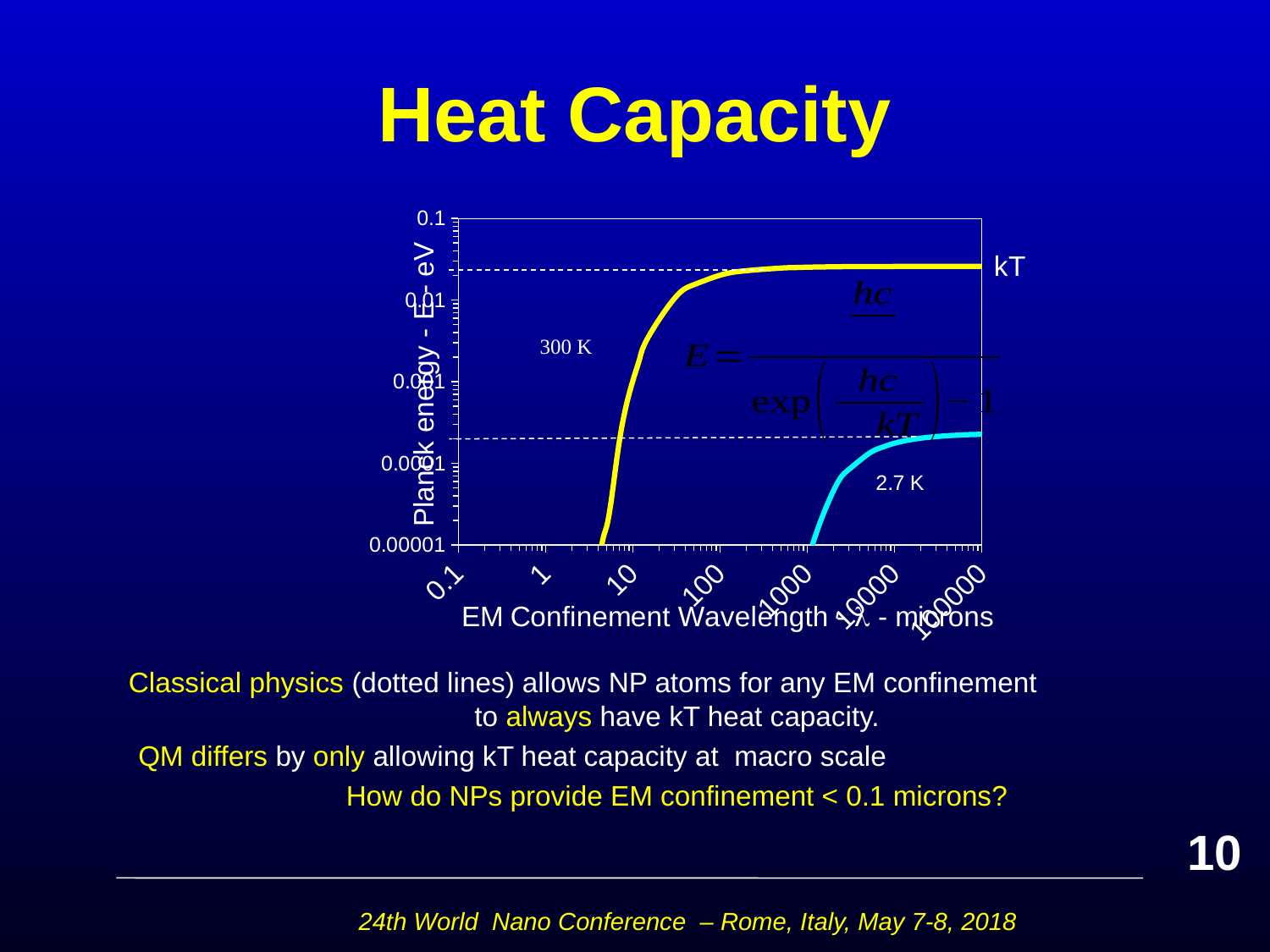
What are the two temperatures labelled on the plotted curves? 300 K and 2.7 K What kind of chart is shown on the slide? line chart What is the label of the x axis of the chart? EM Confinement Wavelength λ - microns What is the lowest value labelled on the y axis of the chart? 0.00001 How many tick labels are shown on the x axis of the chart? 7 Is the Planck energy of the 300 K curve at 1000 microns greater or less than 0.01 eV? greater How many temperature curves are plotted on the chart? 2 At a wavelength of 1000 microns, which curve has the higher Planck energy, 300 K or 2.7 K? 300 K Is the Planck energy of the 2.7 K curve at 10000 microns greater or less than 0.001 eV? less Is the Planck energy of the 300 K curve at 10 microns greater or less than 0.0001 eV? greater Do the plotted curves rise or fall as the EM confinement wavelength increases? rise What is the highest wavelength value labelled on the x axis of the chart? 100000